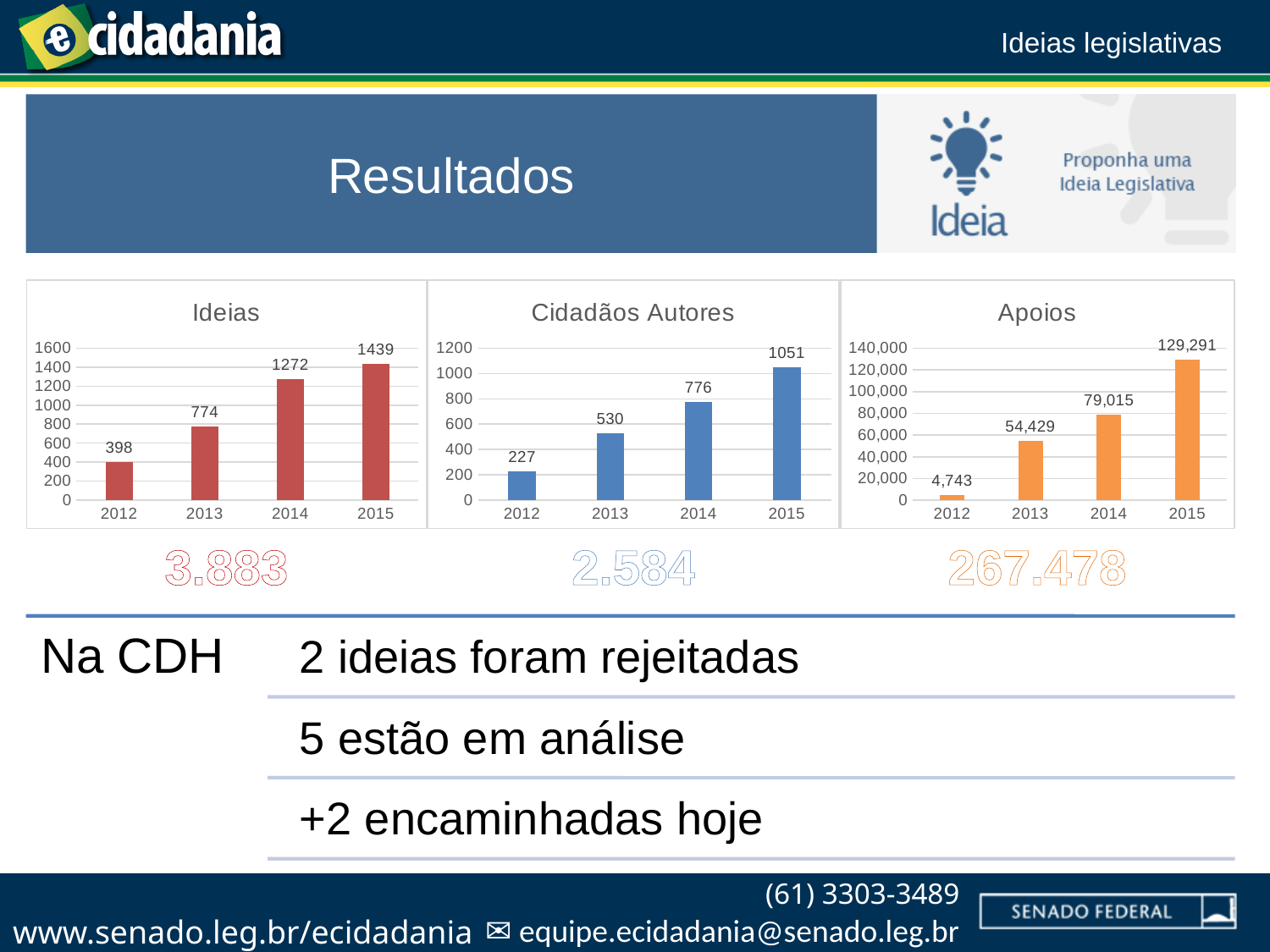
How many years are shown on the x axis of the 'Ideias' chart? 4 In the 'Cidadãos Autores' chart, do the values rise or fall from 2012 to 2015? Rise In the 'Apoios' chart, is the value for 2013 larger than the value for 2014? No In the 'Cidadãos Autores' chart, which year has the highest value? 2015 In the 'Ideias' chart, what is the difference between the values for 2015 and 2012? 1041 In the 'Apoios' chart, what is the difference between the values for 2015 and 2014? 50,276 In the 'Ideias' chart, which year has the lowest value? 2012 In the 'Cidadãos Autores' chart, what is the value for 2013? 530 In the 'Cidadãos Autores' chart, is the value for 2014 greater or less than 800? less What kind of chart is the 'Apoios' chart? Bar chart In the 'Apoios' chart, what is the value for 2012? 4,743 In the 'Ideias' chart, what is the value for 2014? 1272